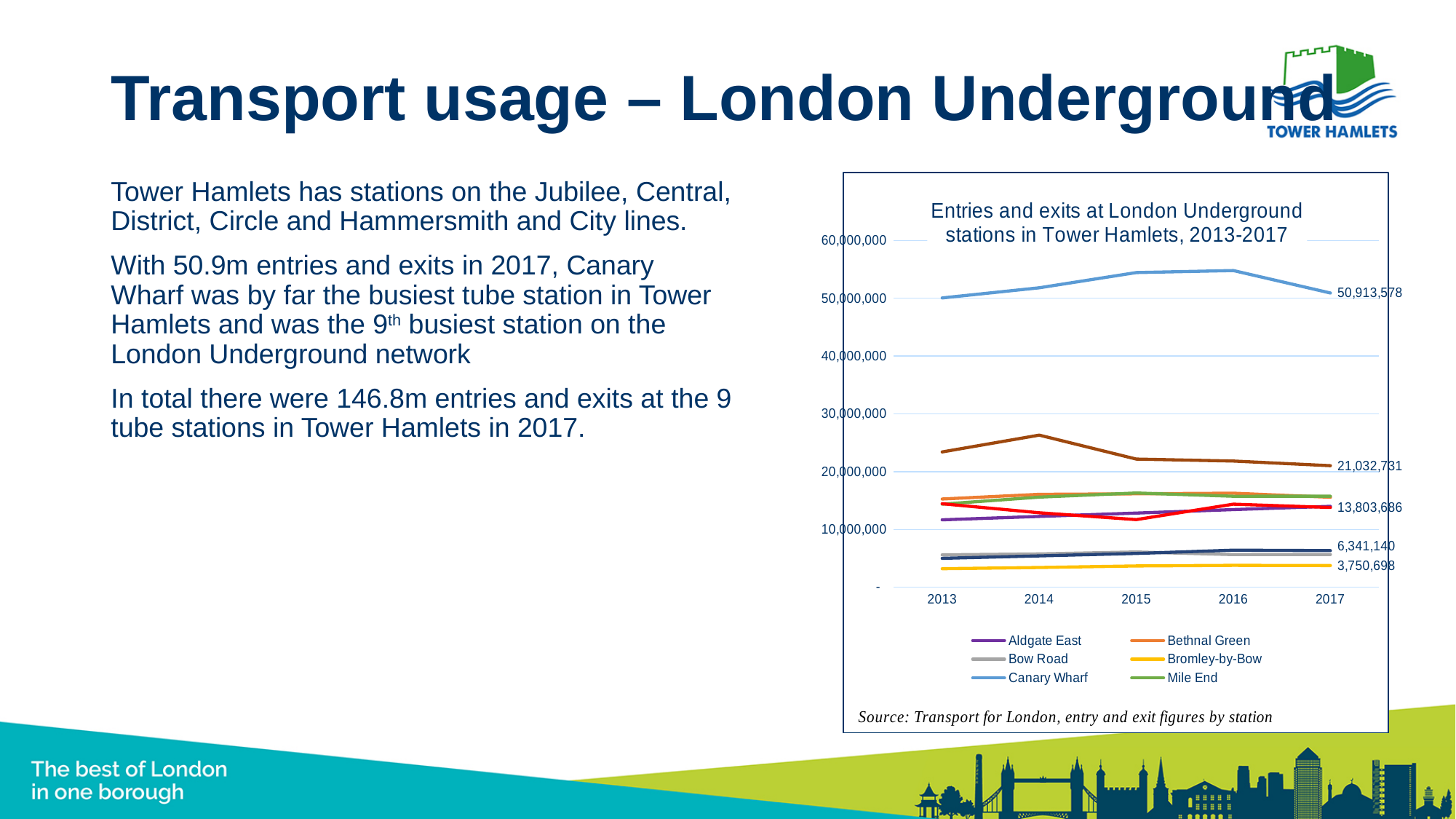
Which station has the highest entries and exits across the chart? Canary Wharf What is the value for Bromley-by-Bow in 2017? 3,750,698 Is the value for Mile End in 2017 greater or less than 10,000,000? greater Did the value for Canary Wharf rise or fall between 2016 and 2017? fall How many years are shown on the x axis of the chart? 5 Is the value for Canary Wharf in 2016 greater or less than 50,000,000? greater Which station has the lowest entries and exits across the chart? Bromley-by-Bow What is the difference between the 2017 values for Canary Wharf and Bromley-by-Bow? 47,162,880 How many series does the chart legend list? 6 What is the title of the chart? Entries and exits at London Underground stations in Tower Hamlets, 2013-2017 What is the value for Canary Wharf in 2017? 50,913,578 What kind of chart is shown on the slide? line chart